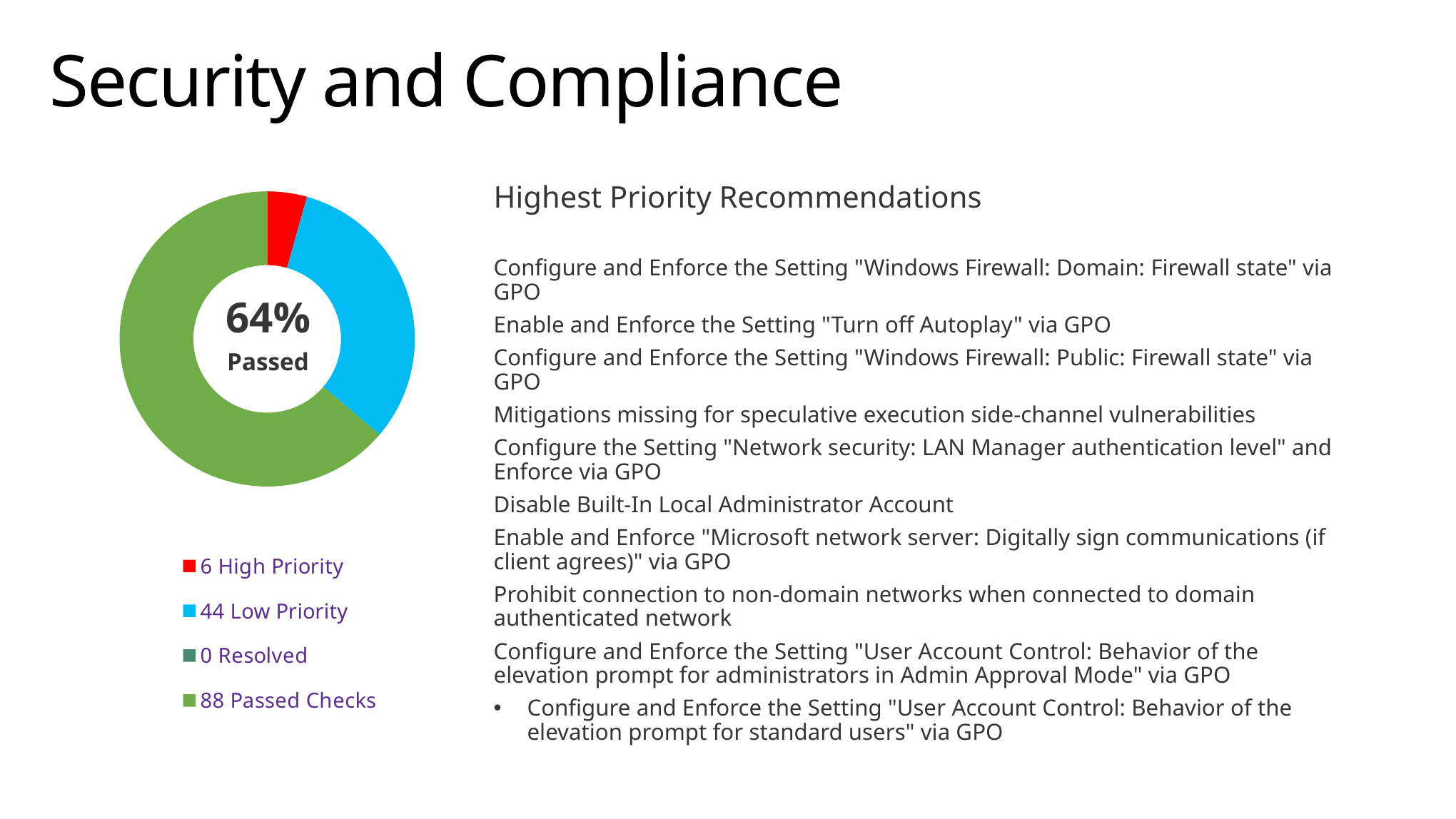
How many categories does the chart legend list? 4 How many Resolved items does the legend show? 0 What is the difference between the number of Passed Checks and the number of Low Priority items? 44 What is the difference between the number of Low Priority and High Priority items? 38 What percentage of checks passed, according to the centre of the donut chart? 64% How many Passed Checks does the legend show? 88 How many Low Priority items does the legend show? 44 Which category has the smallest value in the chart? Resolved Which is larger, the number of Low Priority items or the number of High Priority items? Low Priority What kind of chart is shown on the slide? Donut (pie) chart How many High Priority items does the legend show? 6 Which category has the largest value in the chart? Passed Checks